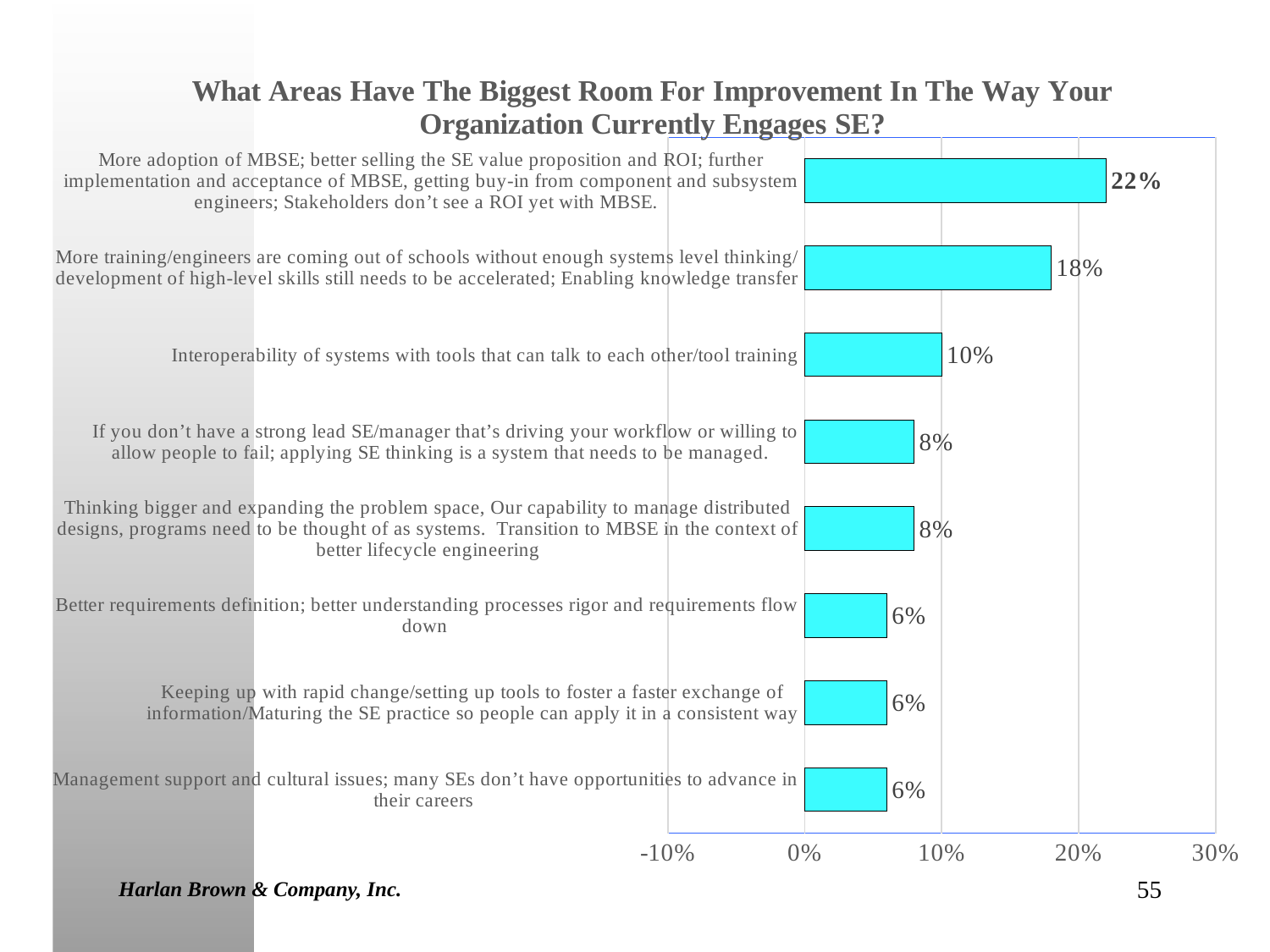
What is the difference between the 'More adoption of MBSE' category and the 'More training/engineers' category? 4% What is the title of the chart? What Areas Have The Biggest Room For Improvement In The Way Your Organization Currently Engages SE? What is the difference between the highest value (22%) and the value for 'Interoperability of systems with tools that can talk to each other/tool training' (10%)? 12% What is the lowest percentage shown on the chart? 6% How many categories are shown on the chart? 8 Which is larger: the value for 'Interoperability of systems with tools that can talk to each other/tool training' or the value for 'Better requirements definition; better understanding processes rigor and requirements flow down'? Interoperability of systems with tools that can talk to each other/tool training What percentage is shown for 'Management support and cultural issues; many SEs don't have opportunities to advance in their careers'? 6% What is the highest percentage shown on the chart? 22% What percentage is shown for 'Interoperability of systems with tools that can talk to each other/tool training'? 10% What type of chart is shown on the slide? Bar chart What value is shown for the category about more training/engineers coming out of schools without enough systems level thinking? 18%